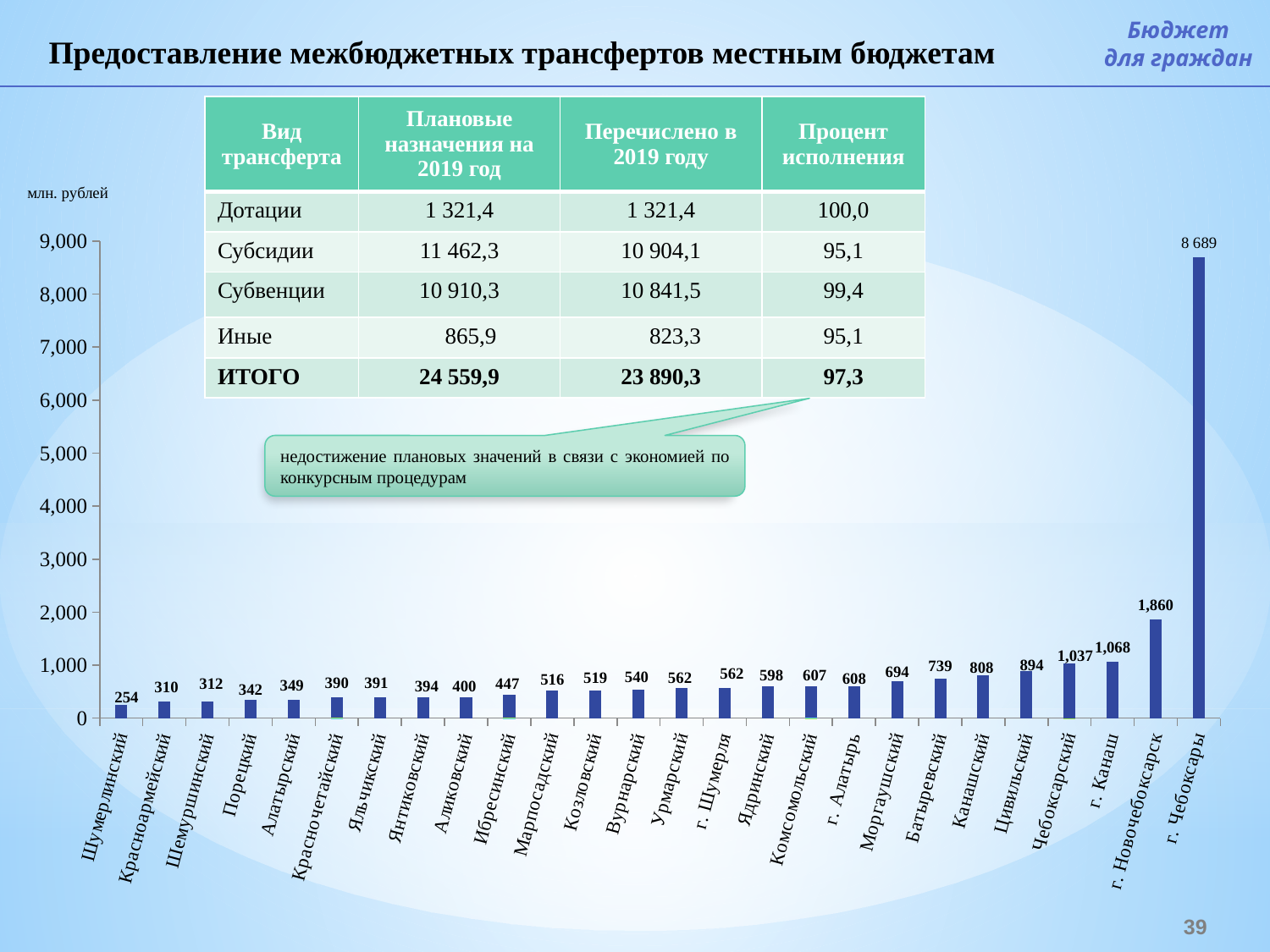
What is the value for Моргаушский? 694 What is the value for Шумерлинский? 254 What unit is indicated above the vertical axis of the chart? млн. рублей Which category has the lowest value? Шумерлинский Is the value for Цивильский greater or less than 1,000? less What is the value for г. Новочебоксарск? 1,860 What type of chart is shown on the slide? bar chart What is the difference between the values for г. Канаш and Чебоксарский? 31 How many categories are shown on the x axis of the chart? 26 What is the value for г. Чебоксары? 8 689 Which is larger, the value for Канашский or the value for Батыревский? Канашский Which category has the highest value? г. Чебоксары